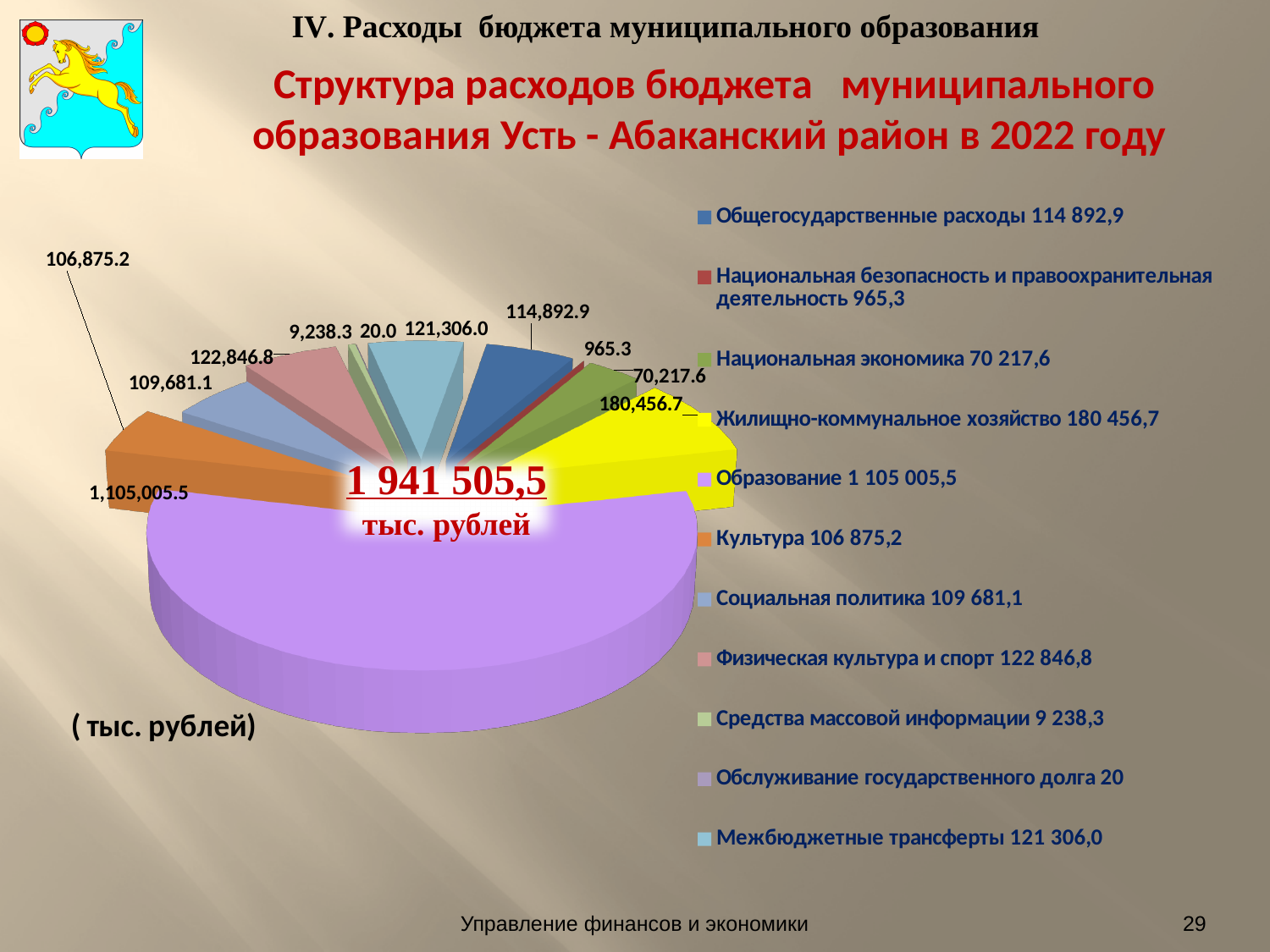
What is the difference between the values for Жилищно-коммунальное хозяйство and Общегосударственные расходы? 65,563.8 What value is labelled on the slice for Межбюджетные трансферты? 121,306.0 What total amount is printed in the centre of the pie chart? 1 941 505,5 тыс. рублей What value is labelled on the slice for Физическая культура и спорт? 122,846.8 What value is labelled on the slice for Жилищно-коммунальное хозяйство? 180,456.7 Which category has the largest slice in the pie chart? Образование What kind of chart is shown on the slide? pie chart What is the title of the chart on the slide? ( тыс. рублей) Which is larger: the value for Культура or the value for Социальная политика? Социальная политика How many categories does the legend of the pie chart list? 11 What value is labelled on the slice for Национальная безопасность и правоохранительная деятельность? 965.3 Which category has the smallest slice in the pie chart? Обслуживание государственного долга